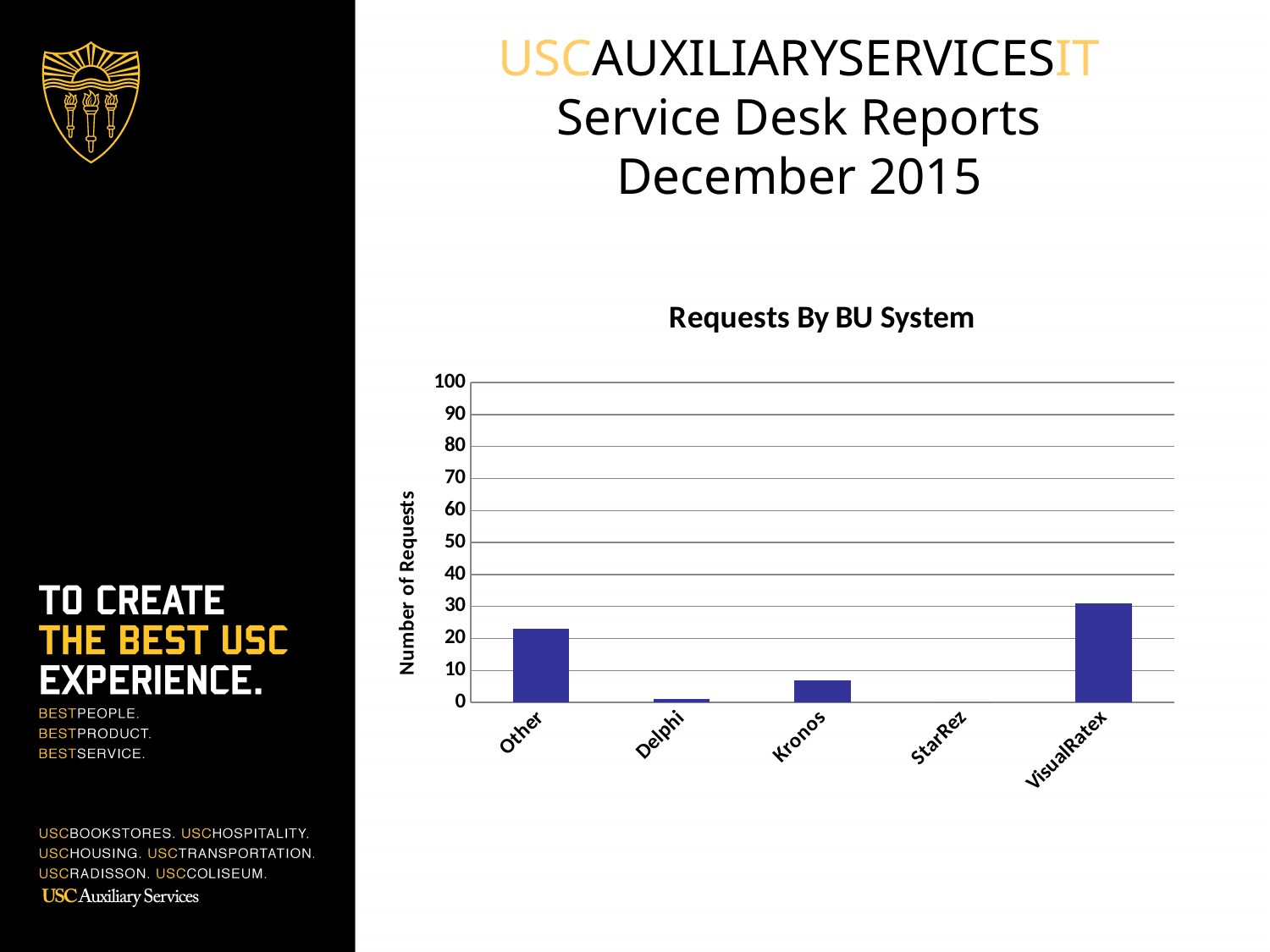
Is the number of requests for Other greater or less than 30? less Which has more requests, Other or VisualRatex? VisualRatex Is the number of requests for Delphi greater or less than 10? less What kind of chart is shown on the slide? bar chart Is the number of requests for Other greater or less than 20? greater What is the title of the chart? Requests By BU System How many BU system categories are shown on the x axis of the chart? 5 Which BU system has the highest number of requests? VisualRatex Which has more requests, Kronos or Other? Other What is the label on the vertical axis of the chart? Number of Requests